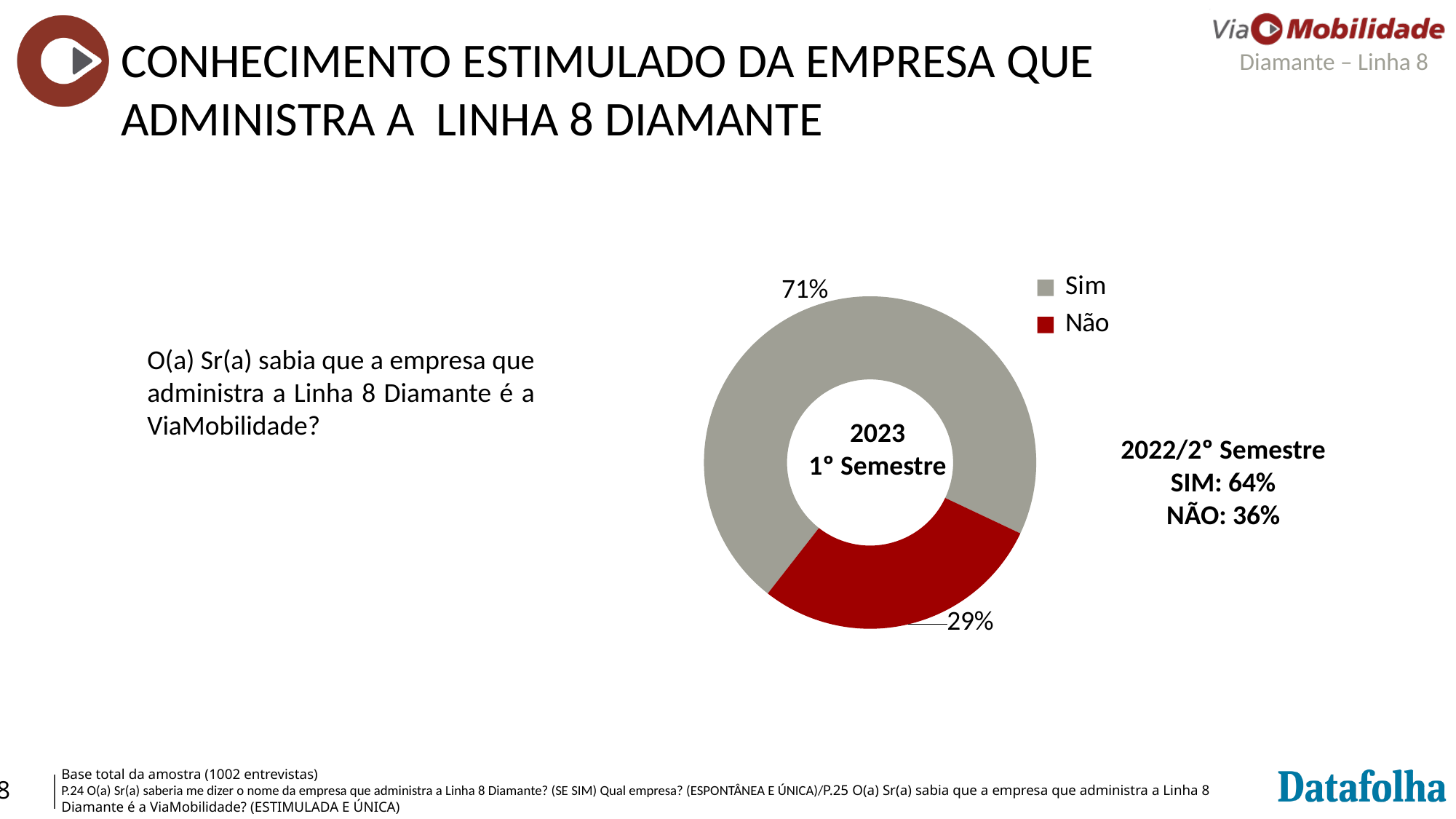
How many entries does the legend of the chart list? 2 What percentage of respondents answered "Sim" in the donut chart? 71% What kind of chart is shown on the slide? Donut (pie) chart How many categories does the donut chart show? 2 What percentage of respondents answered "Não" in the donut chart? 29% What period does the label in the centre of the donut chart refer to? 2023 1° Semestre According to the text beside the chart, what was the "SIM" percentage in 2022/2° Semestre? 64% Which category has the largest share in the donut chart? Sim What colour represents "Não" in the donut chart? Dark red Which is larger in the donut chart, "Sim" or "Não"? Sim Which category has the smallest share in the donut chart? Não What is the difference in percentage points between "Sim" and "Não" in the donut chart? 42